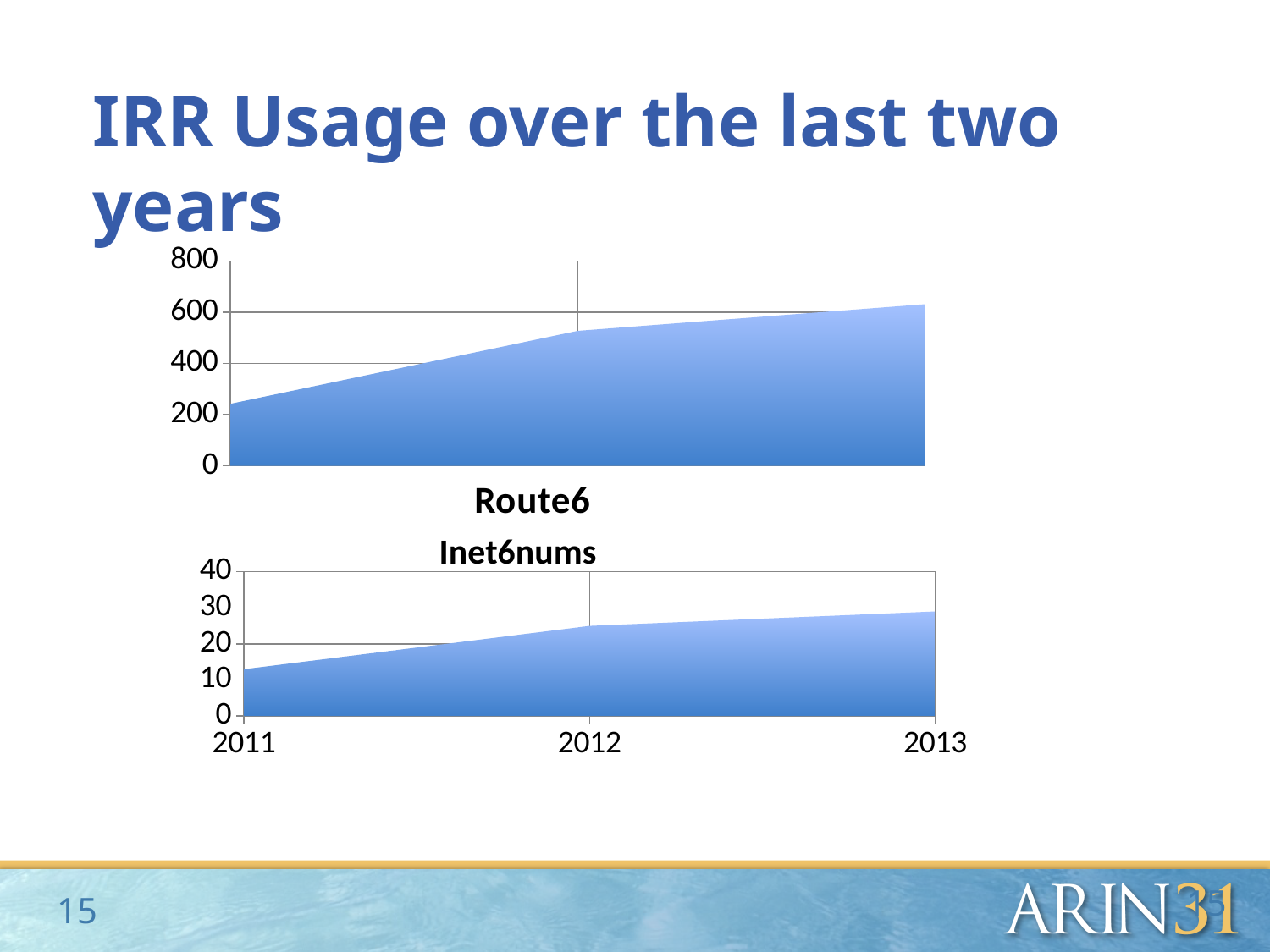
In the Inet6nums chart, do the values rise or fall from 2011 to 2013? rise In the Route6 chart, is the value for 2012 greater or less than 400? greater In the Inet6nums chart, is the value for 2013 greater or less than 20? greater In the Route6 chart, which year has the highest value? 2013 What kind of chart is the Route6 chart? area chart In the Route6 chart, is the value for 2011 greater or less than 400? less How many years are labelled on the x axis of the Inet6nums chart? 3 In the Route6 chart, do the values rise or fall from 2011 to 2013? rise In the Route6 chart, which year has the lowest value? 2011 What is the highest value shown on the y axis of the Route6 chart? 800 In the Inet6nums chart, which year has the lowest value? 2011